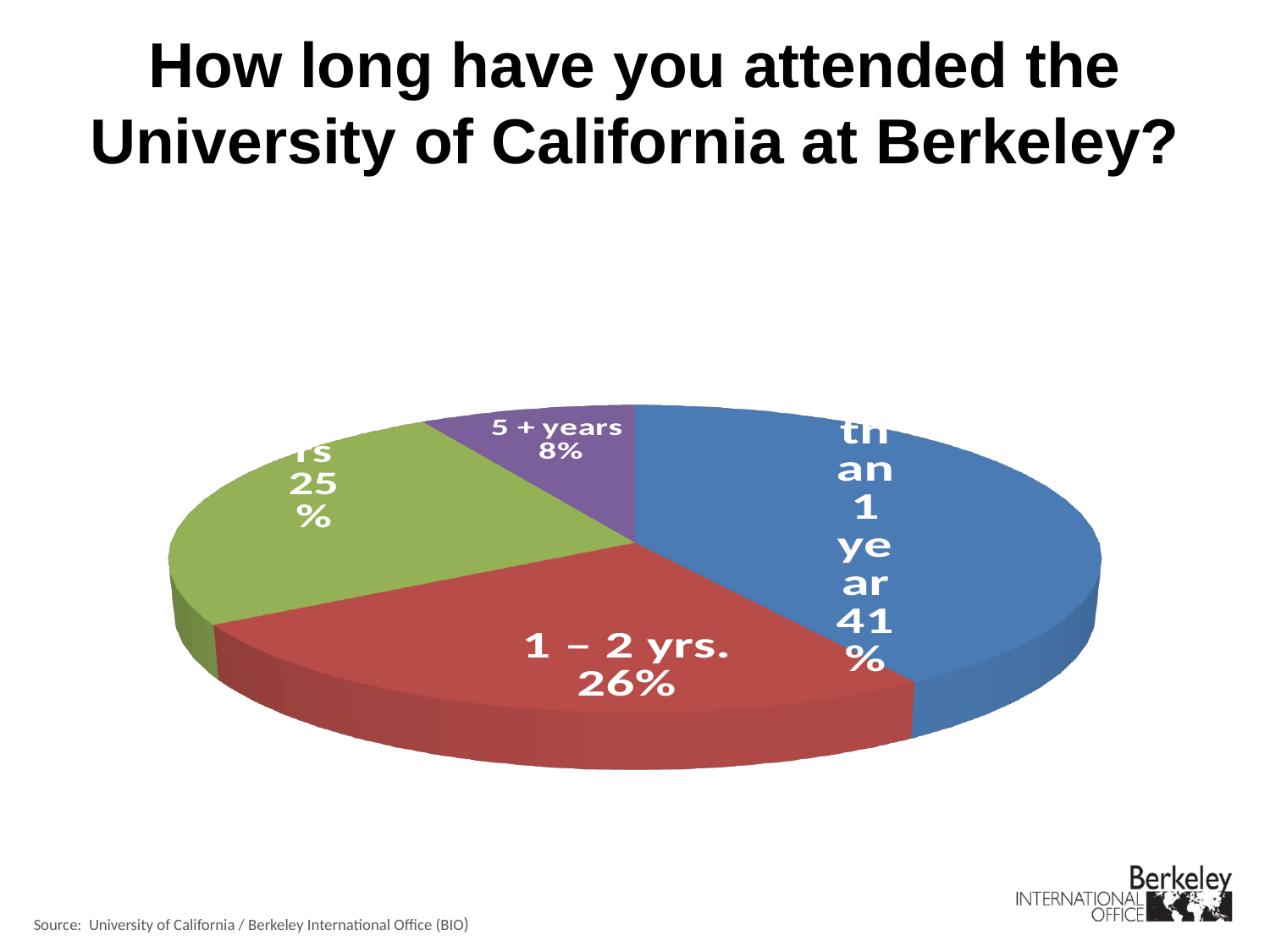
What is the title of the chart on the slide? How long have you attended the University of California at Berkeley? What kind of chart is shown on the slide? Pie chart What percentage of respondents have attended for 1 – 2 yrs.? 26% What is the difference in percentage points between the largest slice (41%) and the 1 – 2 yrs. slice? 15 percentage points Which category has the smallest share of the pie chart? 5 + years How many slices does the pie chart have? 4 Which is larger: the share for 1 – 2 yrs. or the share for 5 + years? 1 – 2 yrs. What percentage is shown on the largest slice of the pie chart? 41% What is the difference in percentage points between the 1 – 2 yrs. slice and the 5 + years slice? 18 percentage points What colour is the 5 + years slice? Purple What percentage is shown on the green slice of the pie chart? 25% What percentage of respondents have attended for 5 + years? 8%